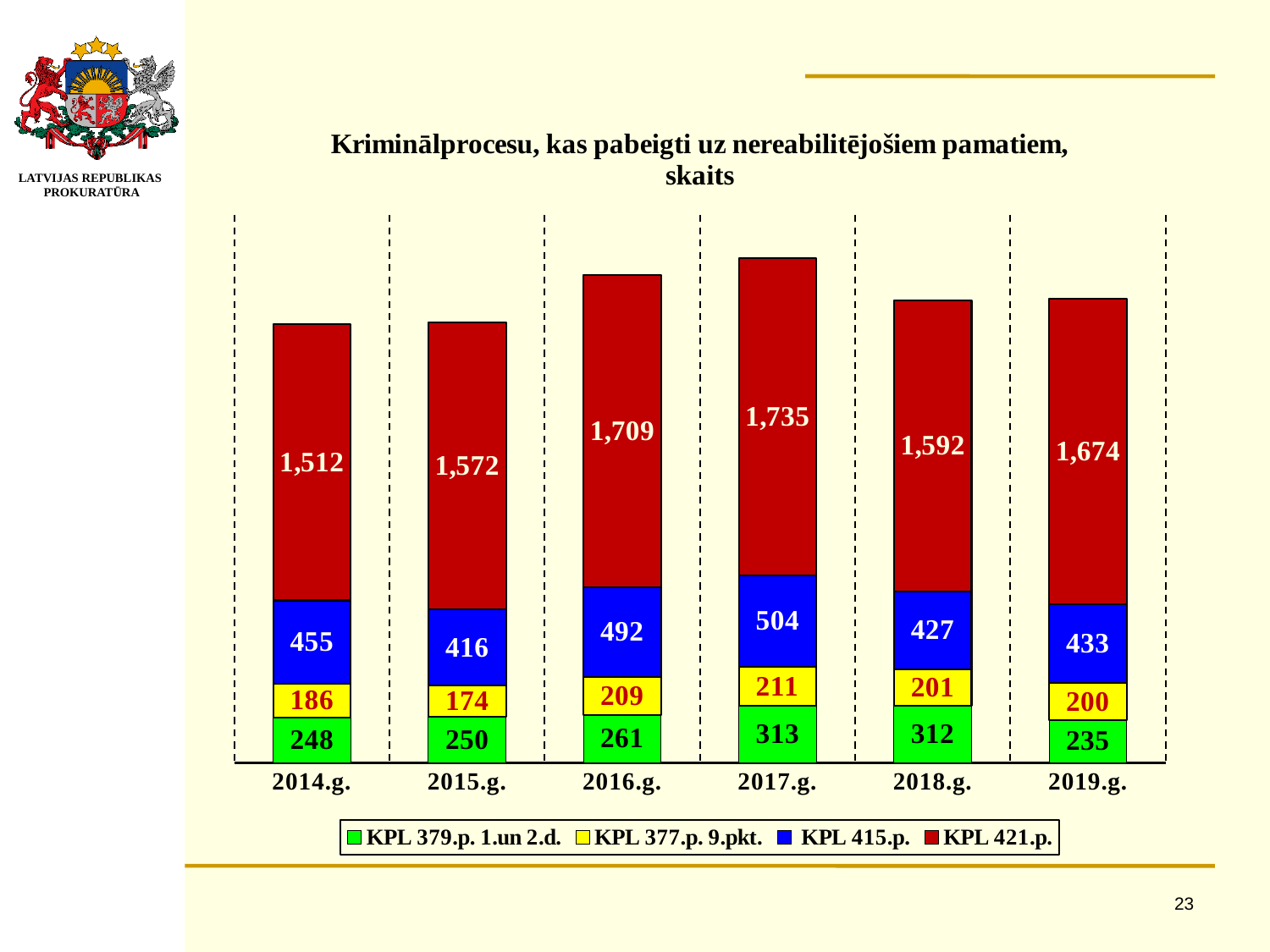
In which year is the KPL 421.p. value lowest? 2014.g. What is the value for KPL 415.p. in 2015.g.? 416 Which series is shown in red in the legend? KPL 421.p. What is the total of the stacked bar for 2014.g.? 2,401 In which year is the KPL 379.p. 1.un 2.d. value highest? 2017.g. What type of chart is shown on the slide? Stacked bar chart How many series does the legend list? 4 Which is larger, the KPL 379.p. 1.un 2.d. value in 2016.g. or in 2019.g.? 2016.g. How many years are shown on the x axis? 6 What is the difference between the KPL 415.p. values for 2017.g. and 2018.g.? 77 What is the value for KPL 421.p. in 2017.g.? 1,735 What is the value for KPL 377.p. 9.pkt. in 2019.g.? 200